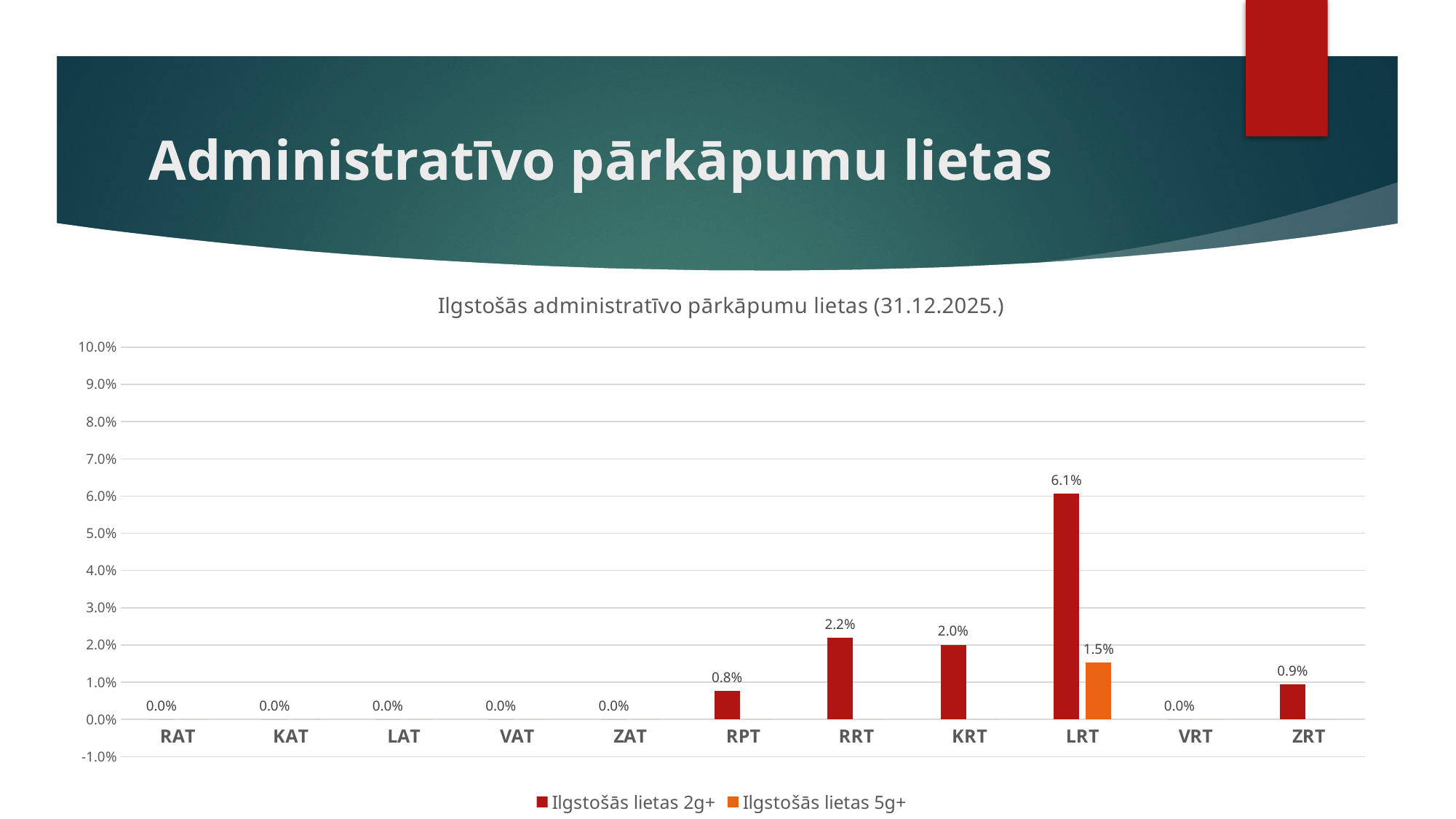
Which is larger, the Ilgstošās lietas 2g+ value for RRT or for RPT? RRT What type of chart is shown on the slide? bar chart What is the title of the chart? Ilgstošās administratīvo pārkāpumu lietas (31.12.2025.) How many series does the legend list? 2 What is the value of Ilgstošās lietas 2g+ for ZRT? 0.9% What is the difference between the Ilgstošās lietas 2g+ and Ilgstošās lietas 5g+ values for LRT? 4.6% What is the value of Ilgstošās lietas 2g+ for LRT? 6.1% Is the Ilgstošās lietas 2g+ value for LRT greater or less than 5.0%? greater How many categories are shown on the x axis? 11 What is the value of Ilgstošās lietas 2g+ for RRT? 2.2% Which category has the highest value for Ilgstošās lietas 2g+? LRT What is the value of Ilgstošās lietas 5g+ for LRT? 1.5%